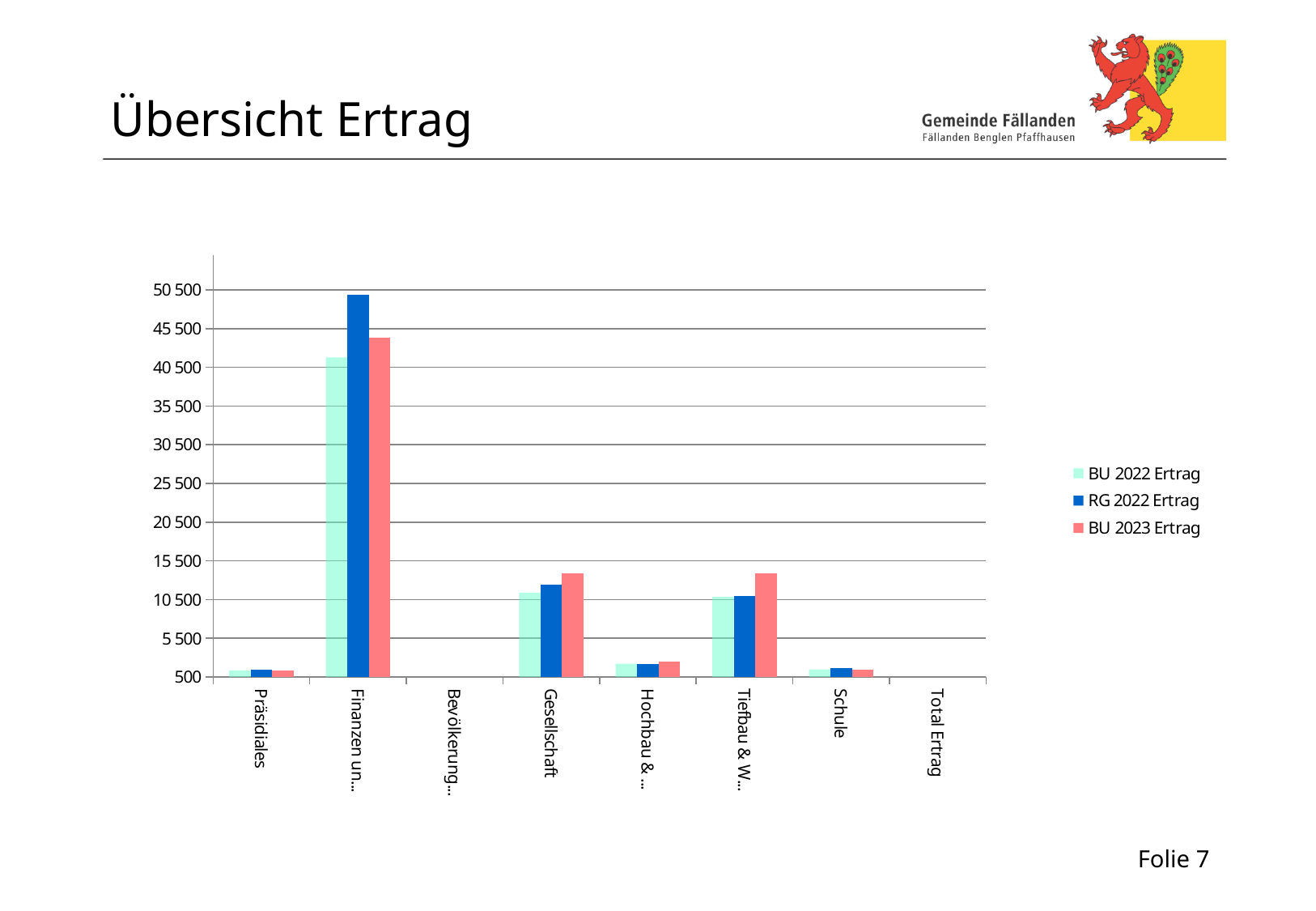
How many series does the legend list? 3 What kind of chart is shown on the slide? bar chart Is the BU 2023 Ertrag value for Hochbau &... greater or less than 5 500? less For Finanzen un..., which is larger: RG 2022 Ertrag or BU 2023 Ertrag? RG 2022 Ertrag How many categories are shown on the x axis? 8 What is the title of the slide containing the chart? Übersicht Ertrag Is the BU 2022 Ertrag value for Finanzen un... greater or less than 35 500? greater Is the RG 2022 Ertrag value for Finanzen un... greater or less than 45 500? greater Which category has the highest values across all series? Finanzen un... For Tiefbau & W..., which is larger: BU 2023 Ertrag or RG 2022 Ertrag? BU 2023 Ertrag